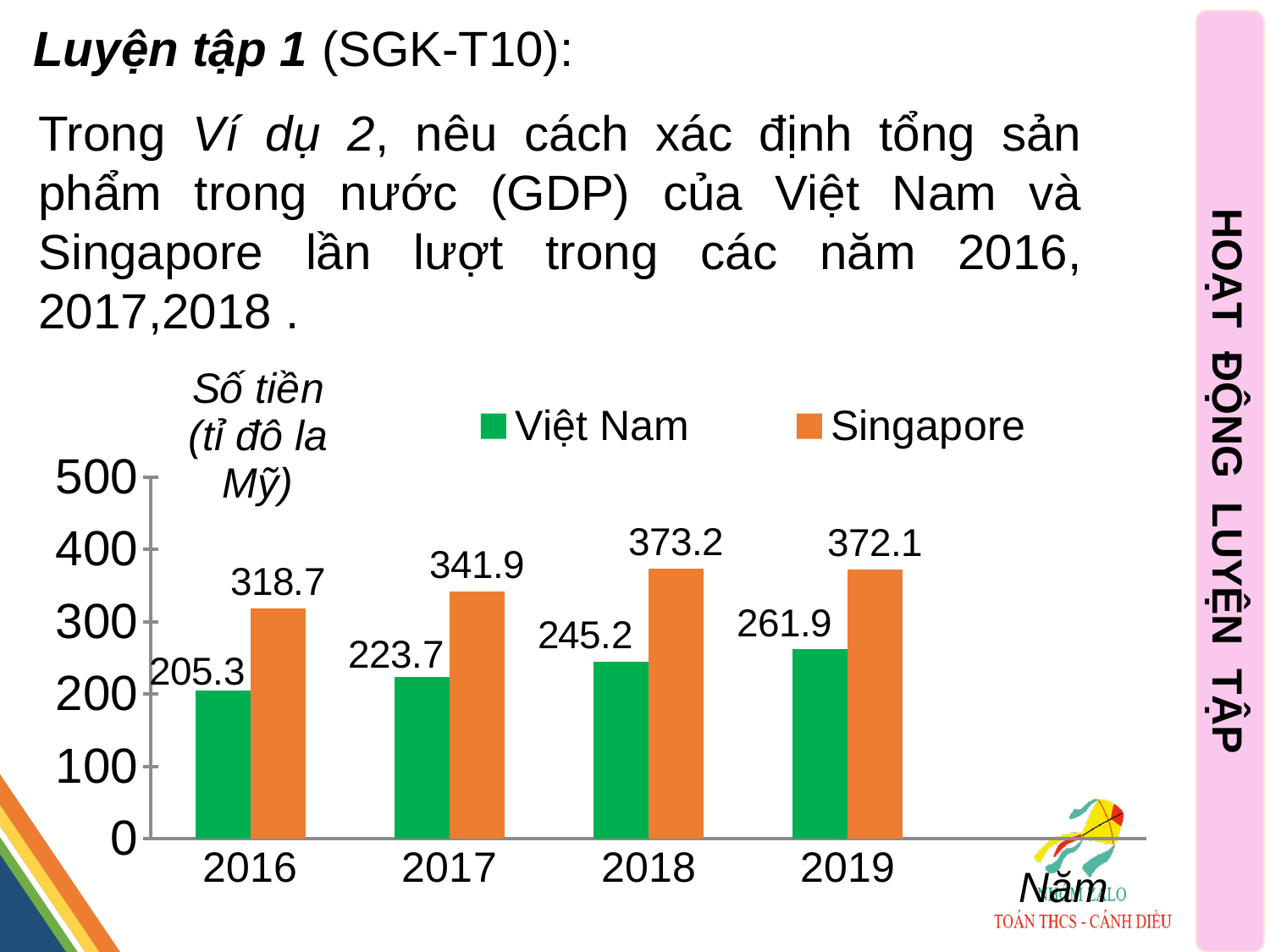
Do the Việt Nam values rise or fall from 2016 to 2019? rise What is the GDP value for Singapore in 2018? 373.2 What is the GDP value for Việt Nam in 2019? 261.9 What is the GDP value for Việt Nam in 2016? 205.3 Is the value for Singapore in 2016 greater or less than 300? greater How many series does the legend list? 2 How many years are shown on the x axis? 4 Which is larger in 2018: the Việt Nam value or the Singapore value? Singapore What kind of chart is shown on the slide? bar chart What is the difference between the Singapore and Việt Nam values in 2017? 118.2 In which year is the Singapore value lowest? 2016 In which year is the Việt Nam value highest? 2019